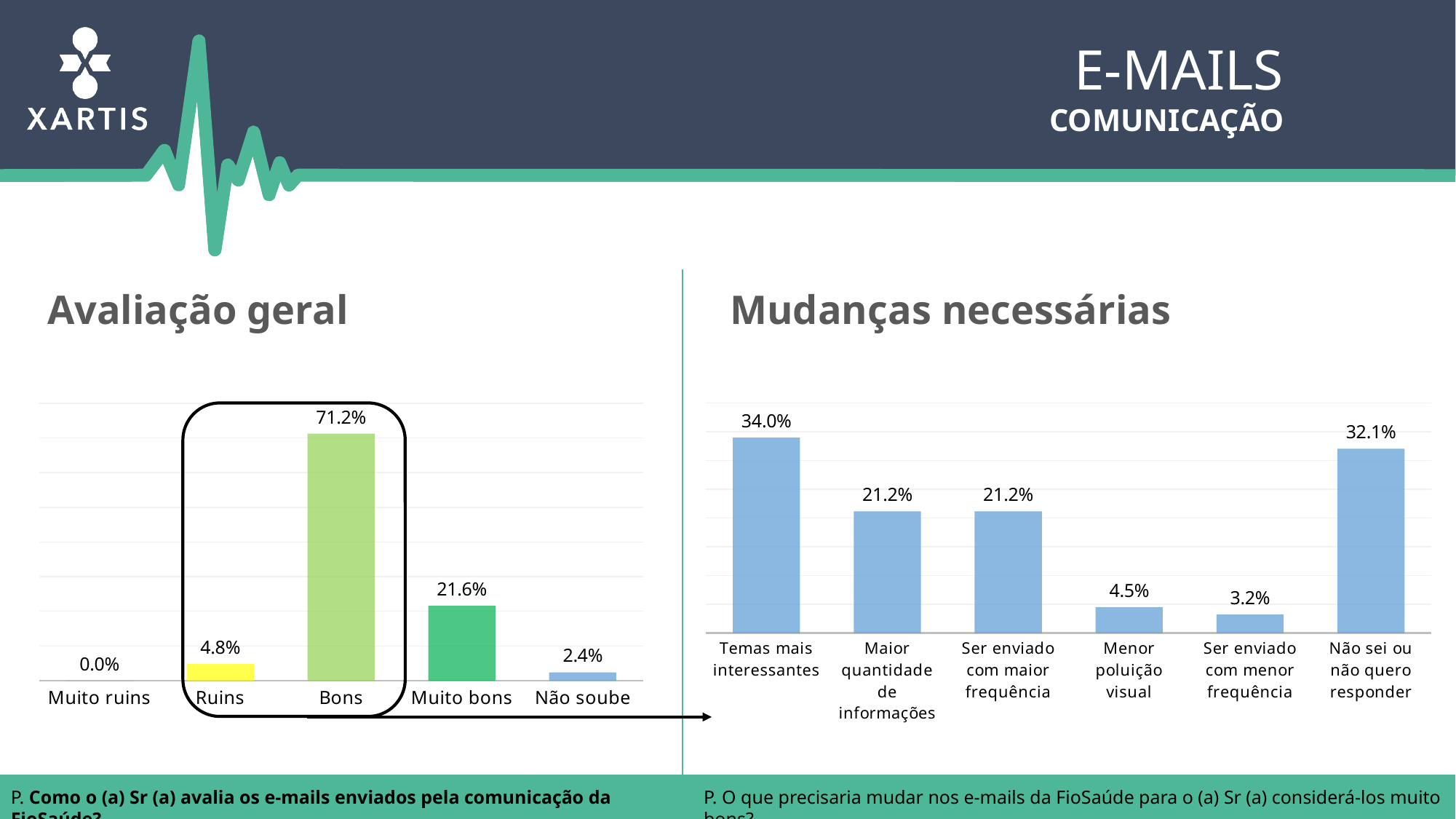
In the 'Mudanças necessárias' chart, what is the value for Temas mais interessantes? 34.0% What type of chart is the 'Mudanças necessárias' chart? Bar chart In the 'Mudanças necessárias' chart, which category has the lowest value? Ser enviado com menor frequência In the 'Mudanças necessárias' chart, which is larger: Temas mais interessantes or Não sei ou não quero responder? Temas mais interessantes In the 'Avaliação geral' chart, what is the difference between Bons and Muito bons? 49.6% In the 'Avaliação geral' chart, what is the value for Muito bons? 21.6% In the 'Avaliação geral' chart, how many categories are shown? 5 In the 'Avaliação geral' chart, which category has the highest value? Bons In the 'Mudanças necessárias' chart, what is the value for Menor poluição visual? 4.5% In the 'Avaliação geral' chart, which category has the lowest value? Muito ruins In the 'Mudanças necessárias' chart, how many categories are shown? 6 In the 'Avaliação geral' chart, what is the value for Bons? 71.2%